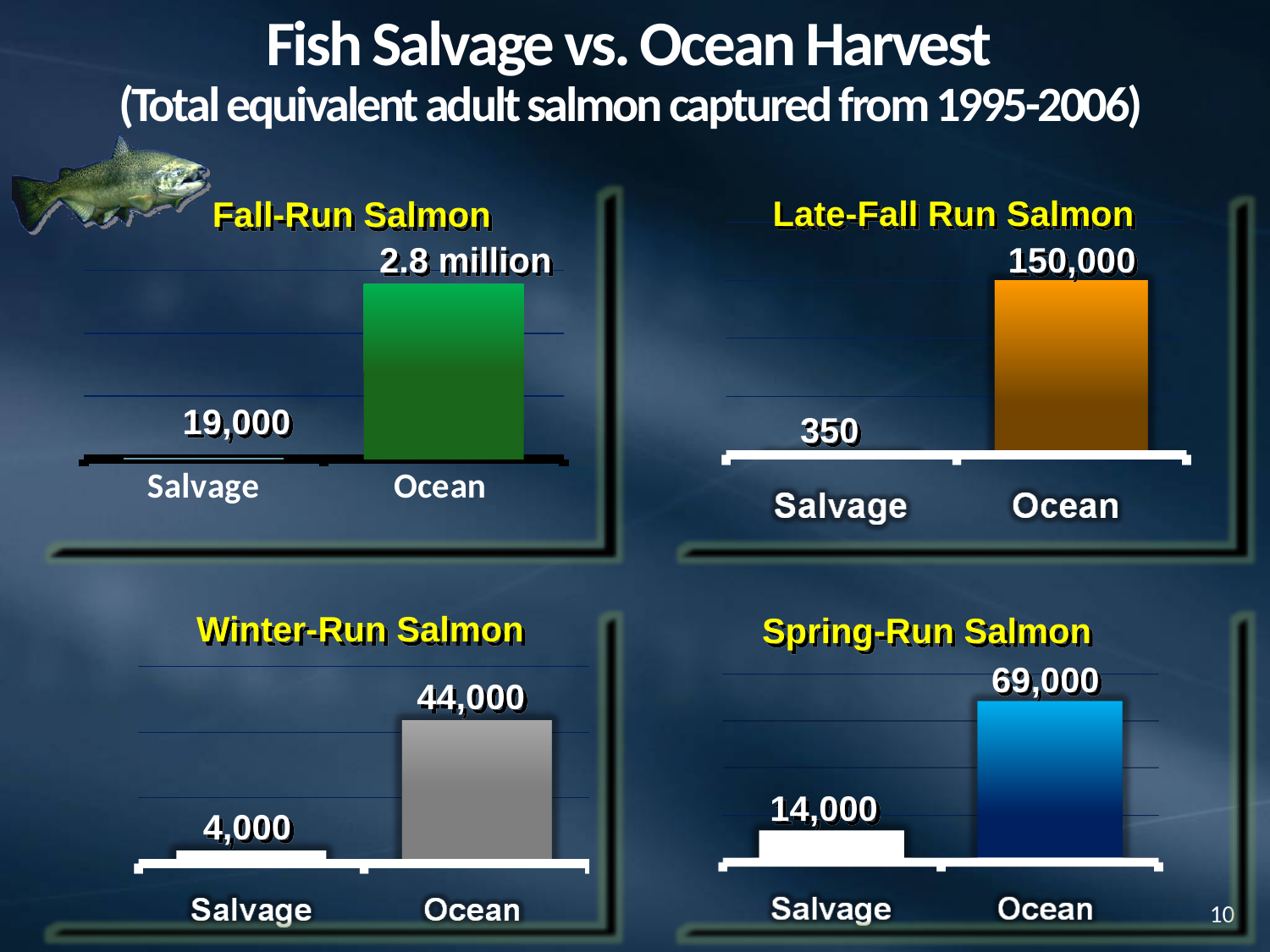
In the Late-Fall Run Salmon chart, which category has the lowest value? Salvage How many categories are shown in the Winter-Run Salmon chart? 2 In the Fall-Run Salmon chart, what is the value for Salvage? 19,000 In the Fall-Run Salmon chart, what is the value for Ocean? 2.8 million In the Spring-Run Salmon chart, which is larger, Salvage or Ocean? Ocean In the Winter-Run Salmon chart, what is the difference between the Ocean and Salvage values? 40,000 In the Winter-Run Salmon chart, what is the value for Ocean? 44,000 In the Spring-Run Salmon chart, what is the value for Salvage? 14,000 In the Late-Fall Run Salmon chart, what is the value for Ocean? 150,000 What type of chart is the Fall-Run Salmon chart? Bar chart In the Spring-Run Salmon chart, what is the difference between the Ocean and Salvage values? 55,000 In the Late-Fall Run Salmon chart, what is the value for Salvage? 350